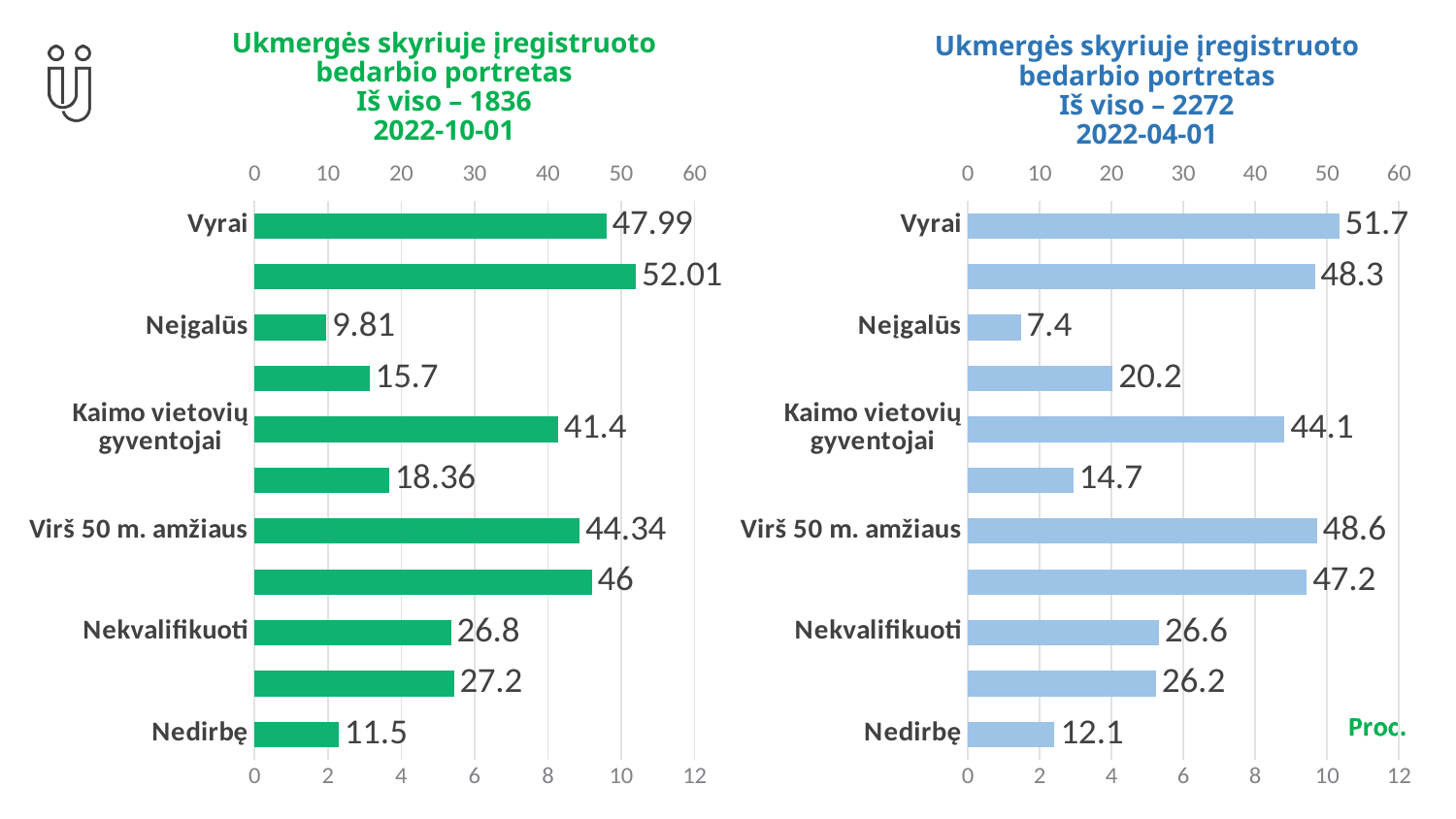
In the left chart (2022-10-01), which labelled category has the lowest value? Neįgalūs In the right chart (2022-04-01), which labelled category has the highest value? Vyrai What kind of chart is shown on the left side of the slide? Bar chart In the right chart (2022-04-01), what is the value for Nedirbę? 12.1 Which is larger: the value for Neįgalūs in the left chart (2022-10-01) or in the right chart (2022-04-01)? Left chart (2022-10-01) In the left chart (2022-10-01), what is the difference between the values for Virš 50 m. amžiaus and Nekvalifikuoti? 17.54 In the left chart (2022-10-01), what is the value for Vyrai? 47.99 In the left chart (2022-10-01), what is the value for Neįgalūs? 9.81 In the right chart (2022-04-01), what is the value for Kaimo vietovių gyventojai? 44.1 In the right chart (2022-04-01), what is the value for Vyrai? 51.7 How many labelled categories are shown in the right chart (2022-04-01)? 6 According to the title of the right chart, what is the total (Iš viso) for 2022-04-01? 2272